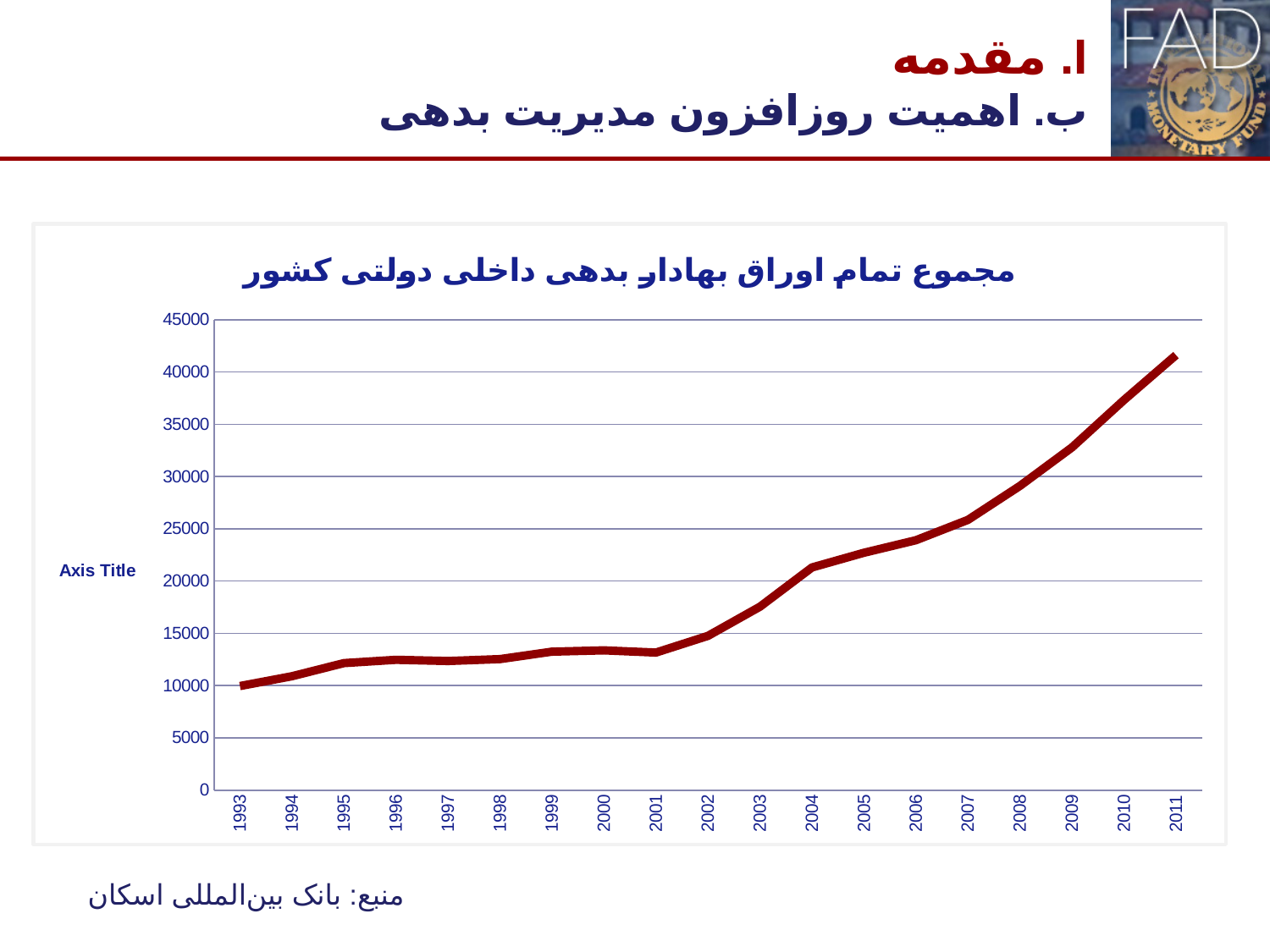
Which year has the highest value in the chart? 2011 Do the values generally rise or fall from 1993 to 2011? rise What is the first year shown on the x axis? 1993 Which year has the lowest value in the chart? 1993 What kind of chart is shown on the slide? line chart Is the value for 2009 greater or less than 30000? greater Is the value for 2011 greater or less than 40000? greater Which year has the larger value, 2004 or 1999? 2004 How many years are plotted along the x axis of the chart? 19 Is the value for 1998 greater or less than 10000? greater What is the highest tick value shown on the y axis? 45000